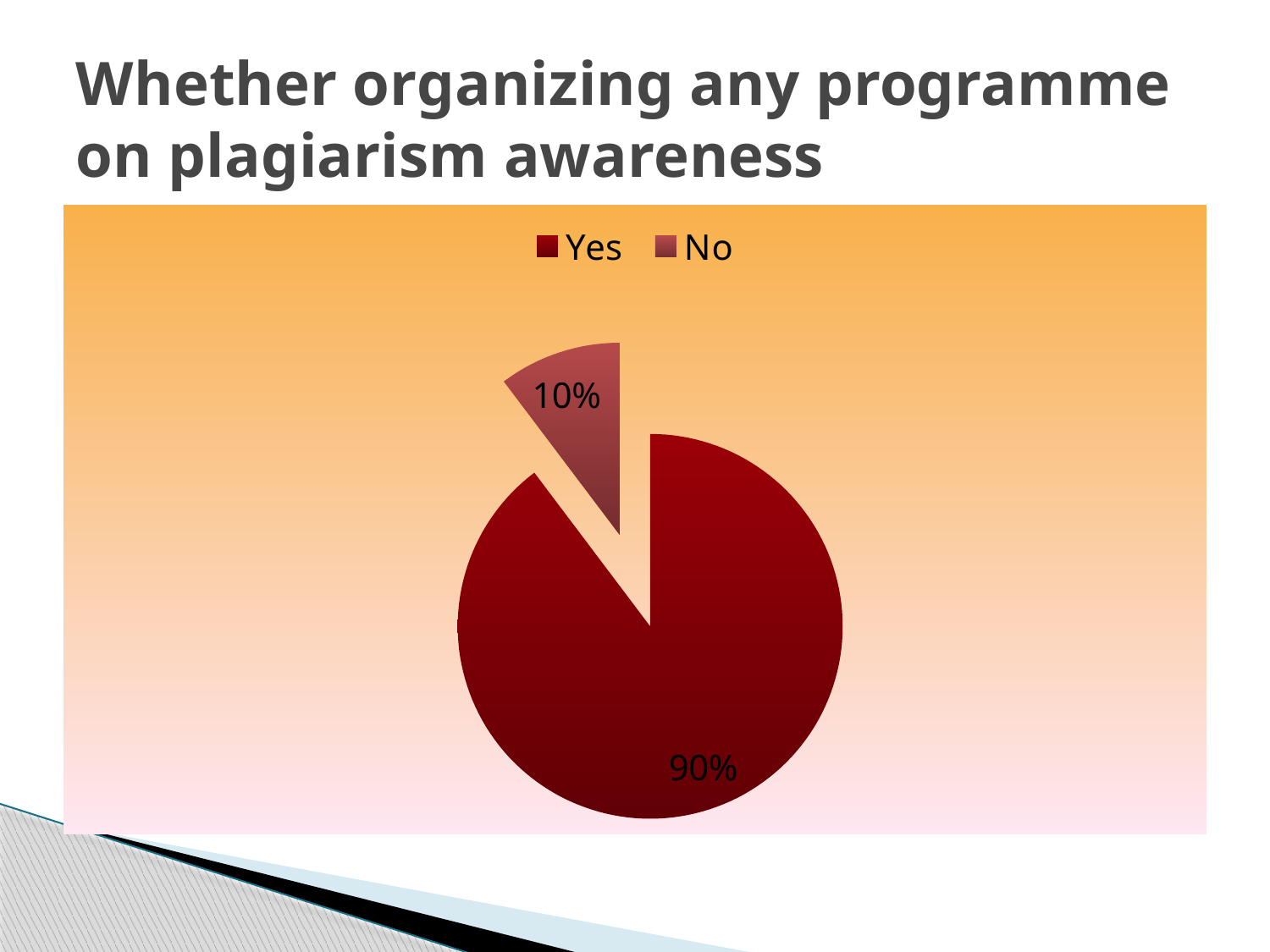
How many entries does the legend list? 2 What share of the pie does the "Yes" slice represent? 90% Which category has the smallest slice of the pie? No Which category has the largest slice of the pie? Yes How many categories does the pie chart show? 2 What kind of chart is shown on the slide? pie chart What is the difference in percentage points between the "Yes" and "No" slices? 80 Which slice is pulled out (exploded) from the pie? No Which is larger, the "Yes" slice or the "No" slice? Yes What is the title of the slide containing the chart? Whether organizing any programme on plagiarism awareness What share of the pie does the "No" slice represent? 10%